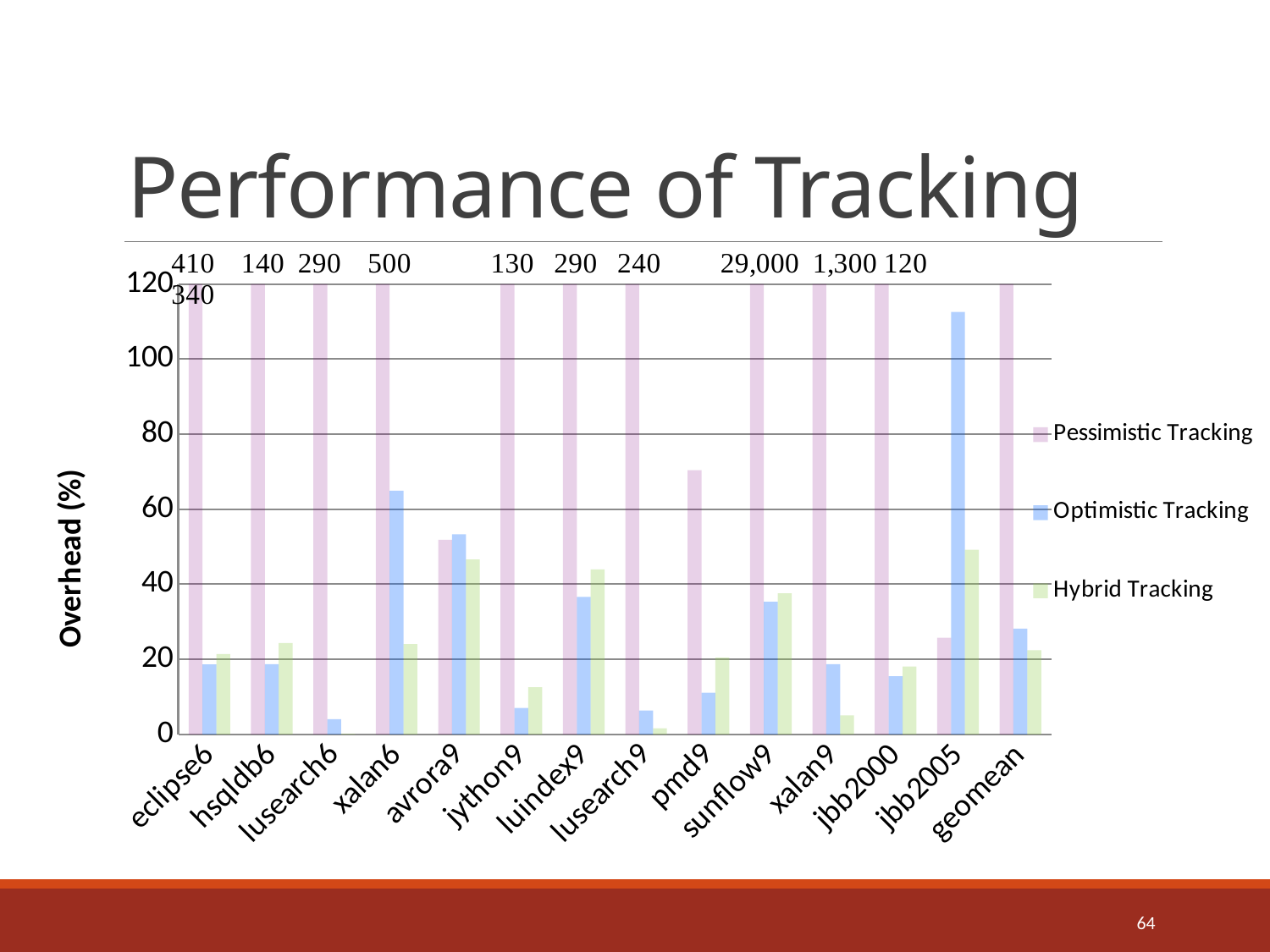
How many benchmark categories are shown along the x axis? 14 What is the y-axis title of the chart? Overhead (%) Is the Pessimistic Tracking value for pmd9 greater or less than 80? less How many series does the legend list? 3 Is the Optimistic Tracking value for jbb2005 greater or less than 100? greater Which category has the lowest Optimistic Tracking overhead? lusearch6 Which category has the highest Optimistic Tracking overhead? jbb2005 Which is larger, the Hybrid Tracking value for jbb2005 or for xalan9? jbb2005 What Pessimistic Tracking overhead is printed above the sunflow9 bar? 29,000 Which series is shown in blue in the legend? Optimistic Tracking What Pessimistic Tracking overhead is printed above the xalan6 bar? 500 What kind of chart is shown on the slide? bar chart